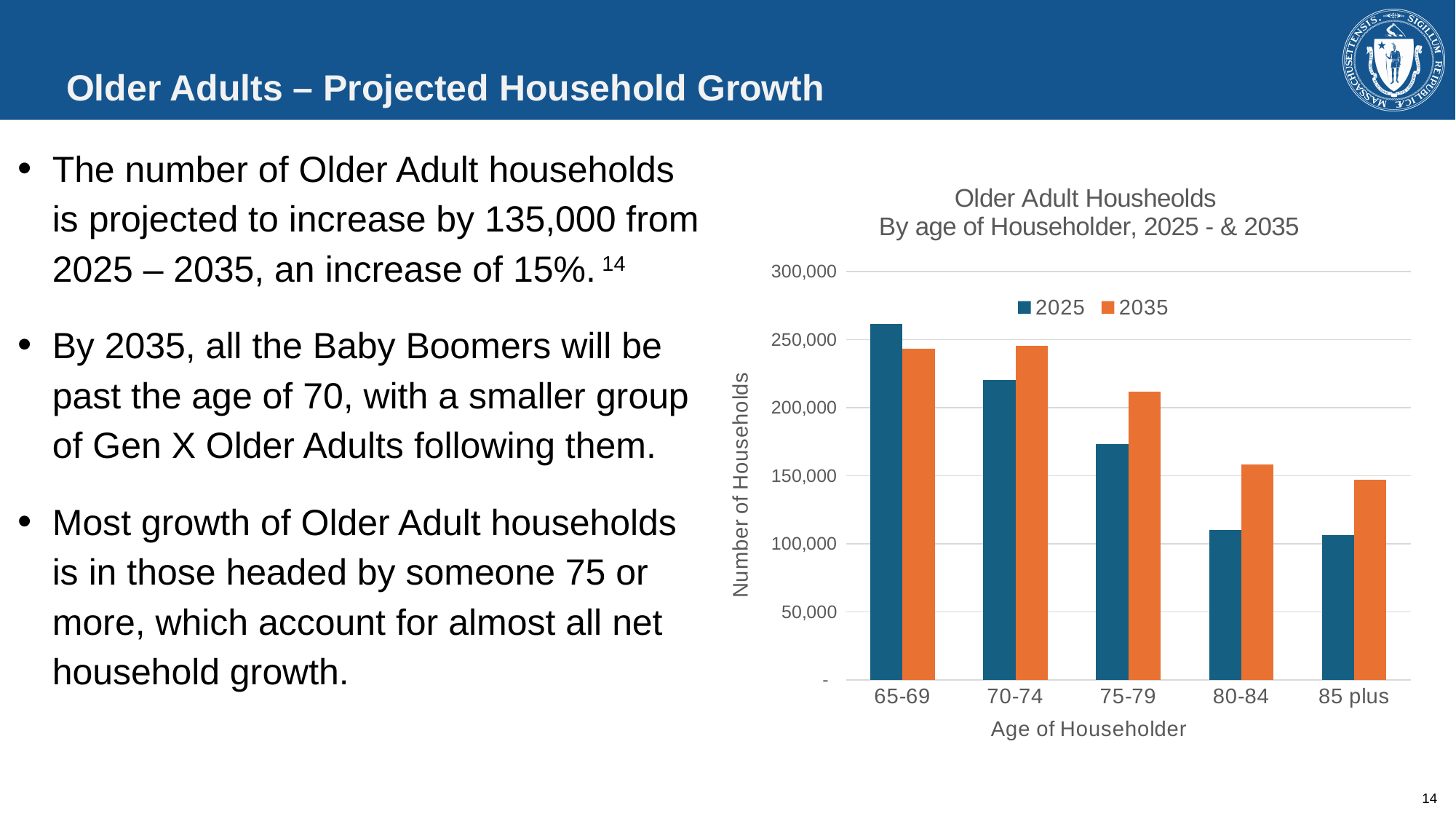
Is the 2025 value for the 75-79 age group greater or less than 200,000? less For the 75-79 age group, which series is larger, 2025 or 2035? 2035 Which age group has the highest number of households in the 2025 series? 65-69 How many series does the chart legend list? 2 Is the 2035 value for the 80-84 age group greater or less than 150,000? greater For the 65-69 age group, which series is larger, 2025 or 2035? 2025 Do the 2025 values rise or fall as the age groups move from 65-69 to 85 plus? Fall What kind of chart is shown on the slide? Bar chart How many age groups are shown on the x axis of the chart? 5 What is the label of the vertical axis of the chart? Number of Households Is the 2025 value for the 65-69 age group greater or less than 250,000? greater Which age group has the lowest number of households in the 2035 series? 85 plus